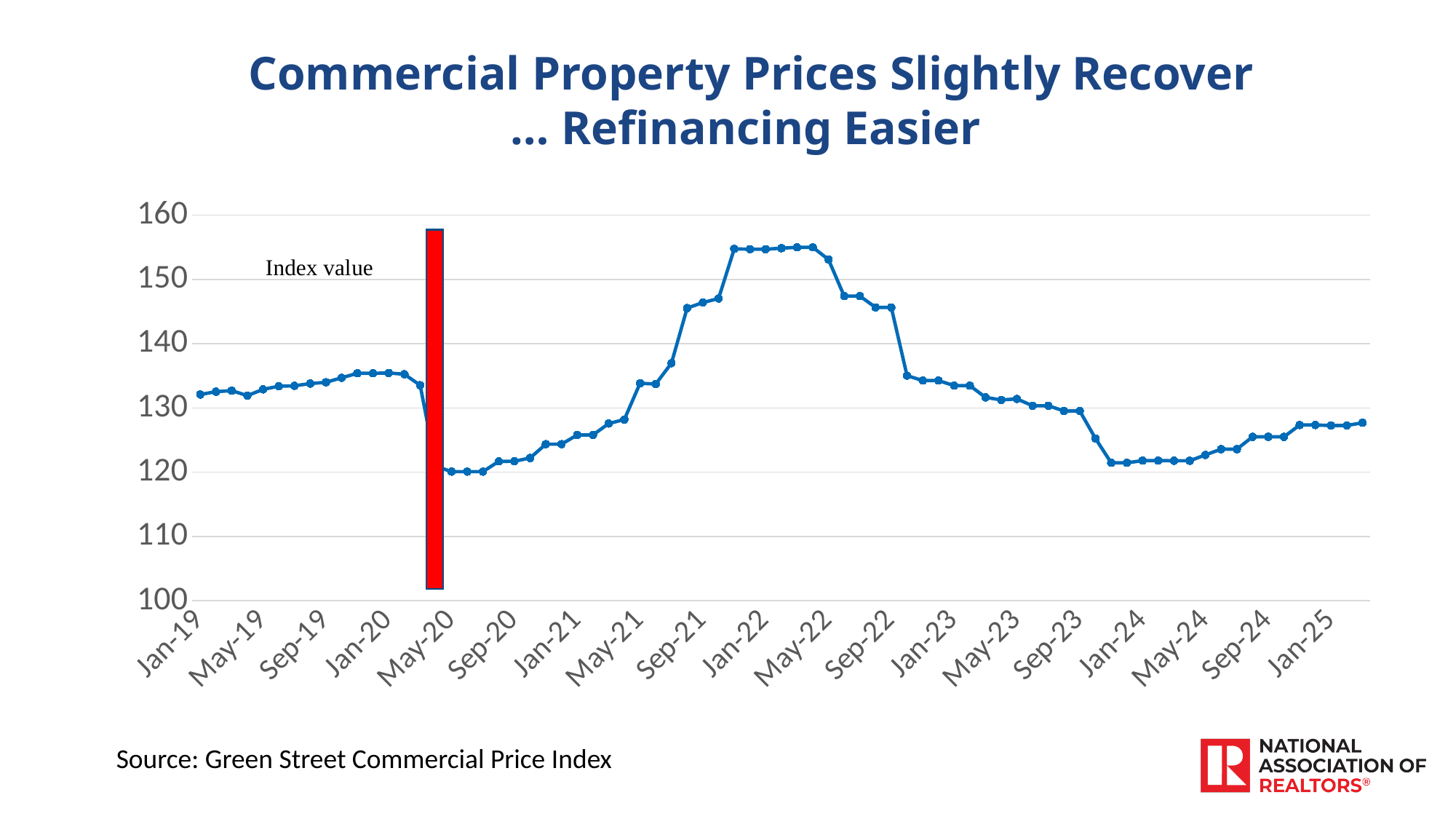
Is the index value for Sep-21 greater or less than 140? greater Which has the larger index value, Jan-22 or Jan-24? Jan-22 Is the index value for Jan-24 greater or less than 130? less Do the index values rise or fall between Sep-22 and Jan-24? fall Is the index value for Jan-19 greater or less than 130? greater Do the index values rise or fall between Sep-20 and Jan-22? rise What is the source cited for the chart? Green Street Commercial Price Index Which has the larger index value, Jan-19 or Sep-20? Jan-19 What kind of chart is shown on the slide? line chart